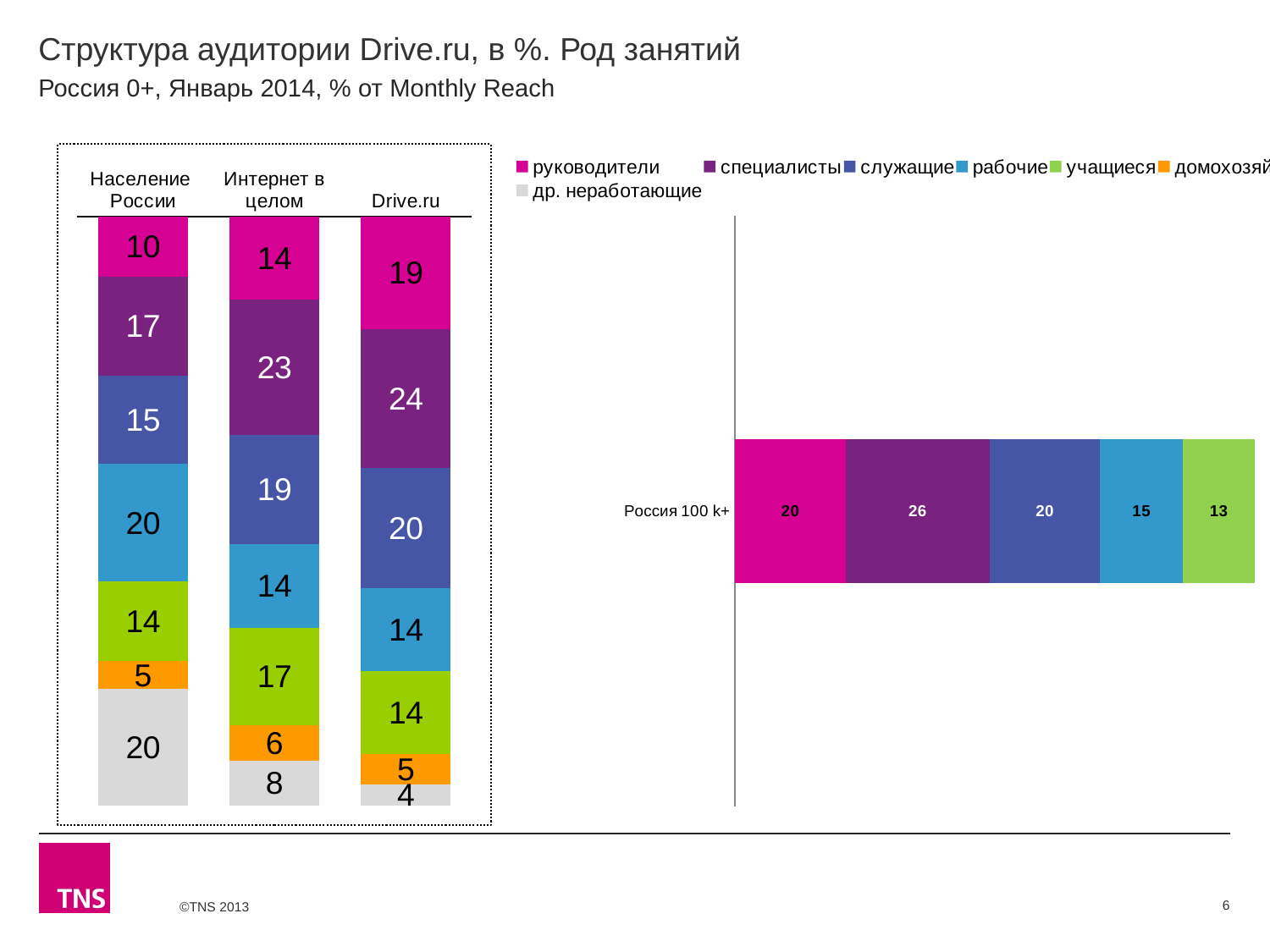
In the right chart (Россия 100 k+), which segment has the highest value? специалисты In the right chart (Россия 100 k+), what is the value for рабочие? 15 In the left chart, which column has the highest value for руководители? Drive.ru In the left chart, what is the difference between the руководители value for Drive.ru and for Население России? 9 How many columns (categories) does the left chart show? 3 In the left chart, what is the value for специалисты in the Drive.ru column? 24 In the left chart, which is larger: the специалисты value for Drive.ru or for Интернет в целом? Drive.ru In the left chart, what is the value for учащиеся in the Интернет в целом column? 17 In the left chart, what is the value for руководители in the Население России column? 10 In the right chart (Россия 100 k+), what is the value for специалисты? 26 How many series does the legend on the slide list? 7 In the left chart, what is the value for др. неработающие in the Drive.ru column? 4